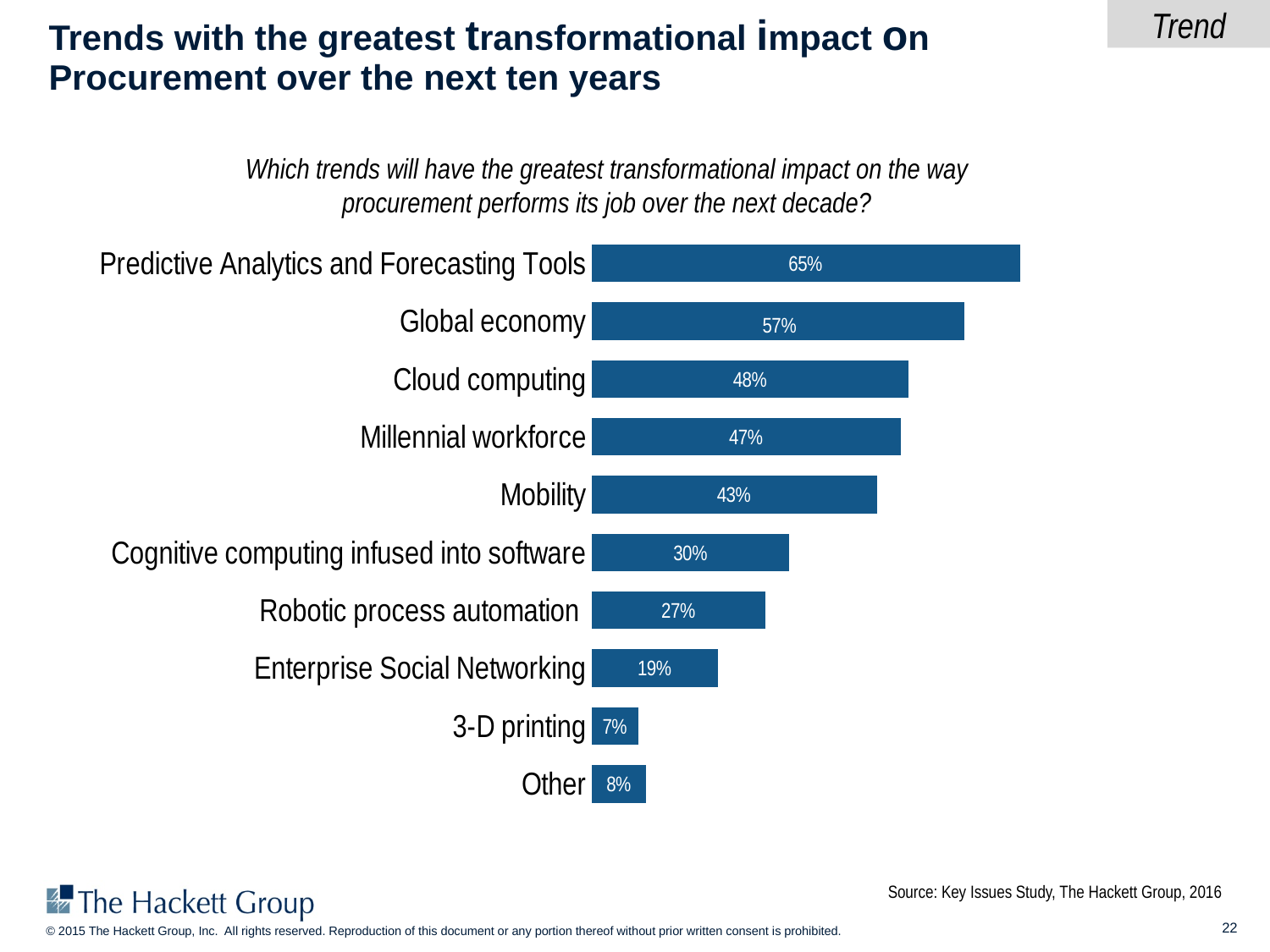
Which trend has the highest percentage? Predictive Analytics and Forecasting Tools What is the difference between the values for Global economy and Mobility? 14% Which is larger, the value for Other or the value for 3-D printing? Other What kind of chart is shown on the slide? Bar chart What is the value for Cloud computing? 48% What is the source cited for the chart? Key Issues Study, The Hackett Group, 2016 What is the difference between the values for Cognitive computing infused into software and Robotic process automation? 3% Which trend has the lowest percentage? 3-D printing Which is larger, the value for Millennial workforce or the value for Mobility? Millennial workforce What percentage is shown for Enterprise Social Networking? 19% How many trends are listed in the chart? 10 What percentage is shown for Predictive Analytics and Forecasting Tools? 65%